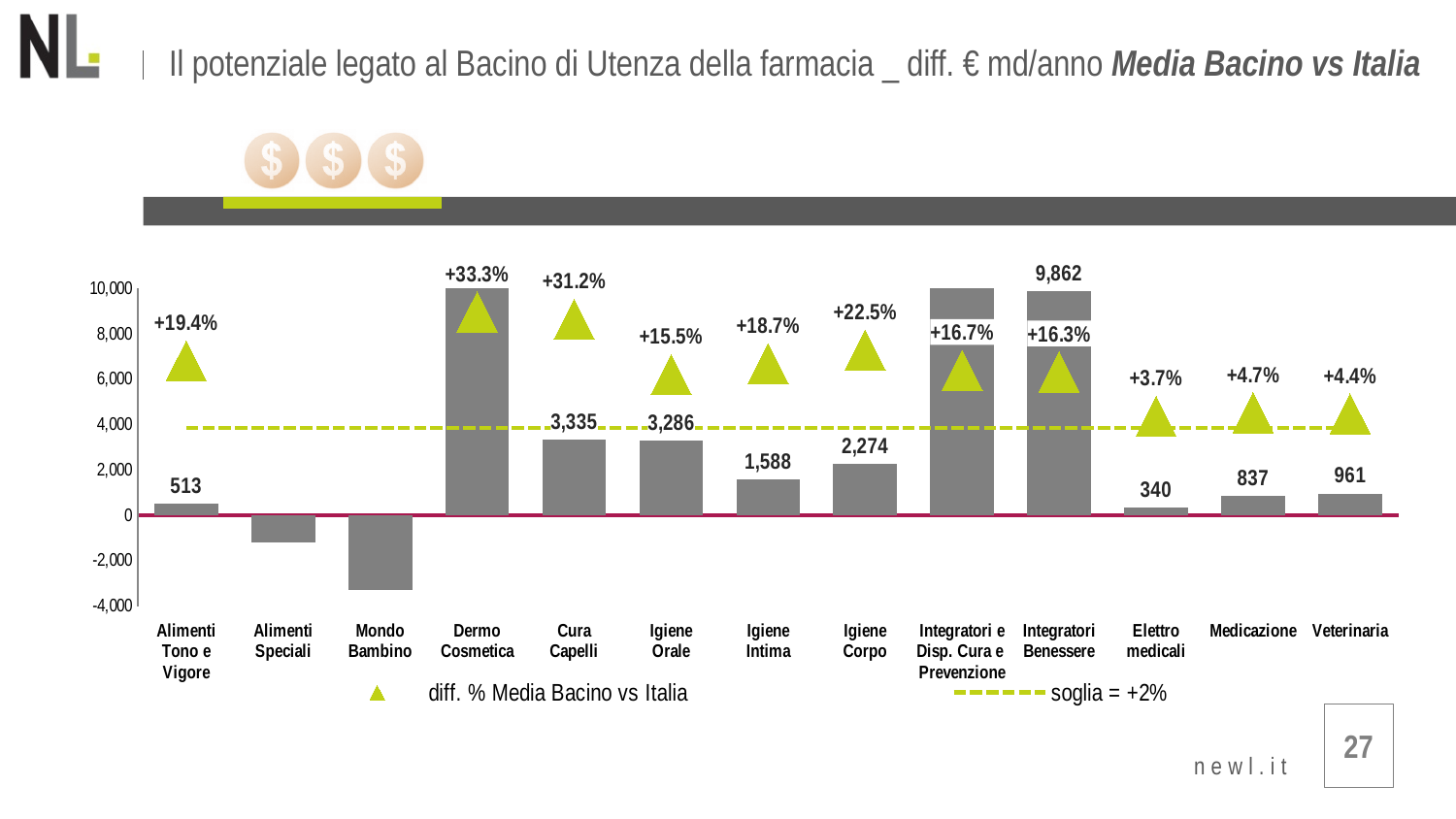
Which has the larger bar value, Medicazione or Veterinaria? Veterinaria What is the value of the bar for Elettro medicali? 340 What is the value of the bar for Cura Capelli? 3,335 What value does the dashed 'soglia' line in the legend represent? +2% What is the diff. % Media Bacino vs Italia shown for Dermo Cosmetica? +33.3% Which category has the lowest diff. % Media Bacino vs Italia? Elettro medicali What is the difference between the bar values for Cura Capelli and Igiene Orale? 49 Which category has the highest diff. % Media Bacino vs Italia? Dermo Cosmetica What is the value of the bar for Integratori Benessere? 9,862 What is the diff. % Media Bacino vs Italia shown for Igiene Corpo? +22.5% Is the bar value for Mondo Bambino greater or less than -2,000? less How many categories are shown on the x axis of the chart? 13